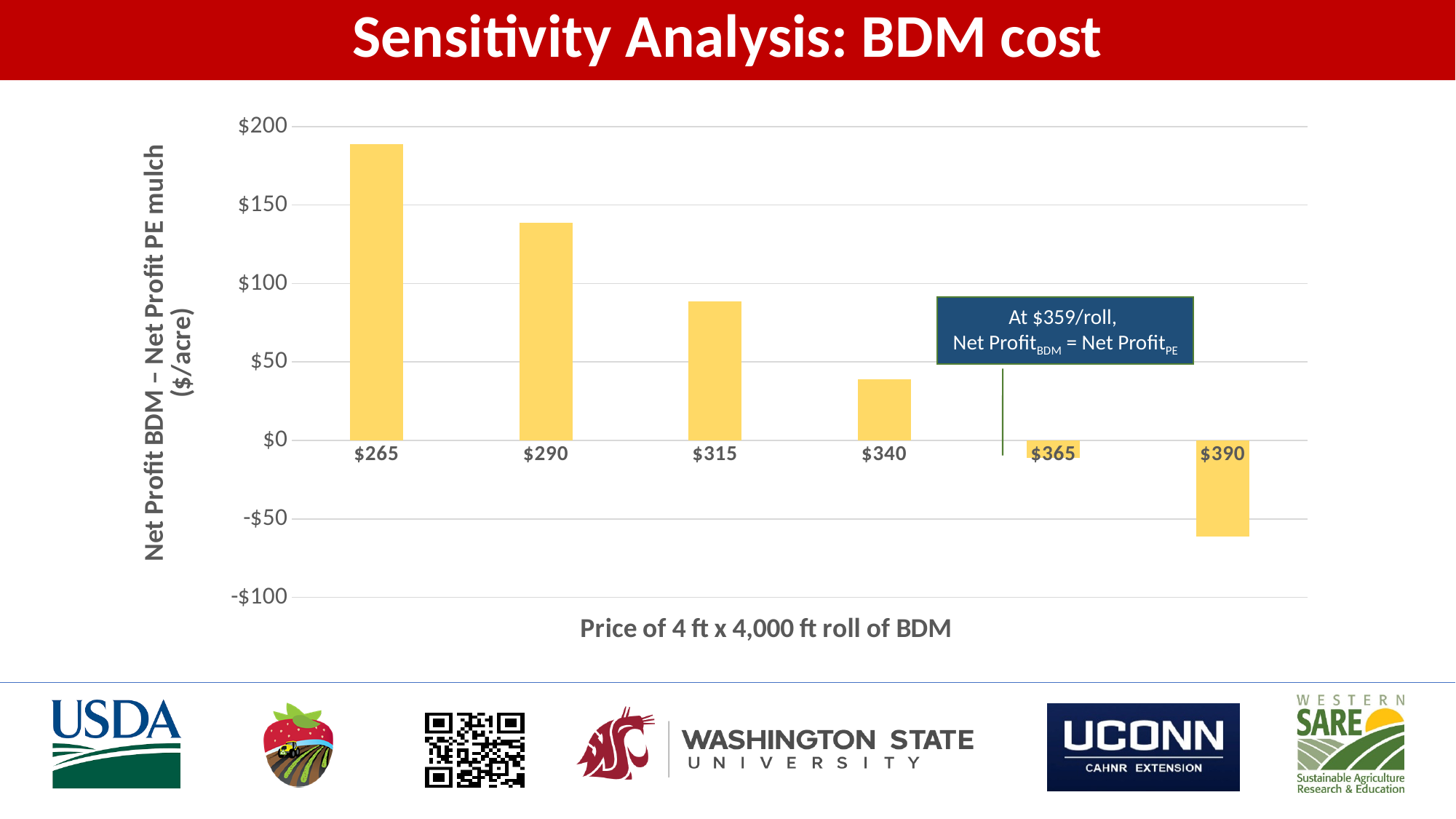
According to the annotation box, at what price per roll does Net Profit BDM equal Net Profit PE? $359/roll Is the value for $265 greater or less than $150? greater Which BDM roll price has the highest net profit difference? $265 Is the value for $390 greater or less than -$50? less Which has the larger value, $290 or $315? $290 Is the value for $340 greater or less than $50? less What kind of chart is shown on the slide? bar chart Do the bar values rise or fall as the roll price increases along the x axis? fall Which BDM roll price has the lowest net profit difference? $390 What is the title of the slide? Sensitivity Analysis: BDM cost How many price categories are plotted on the x axis? 6